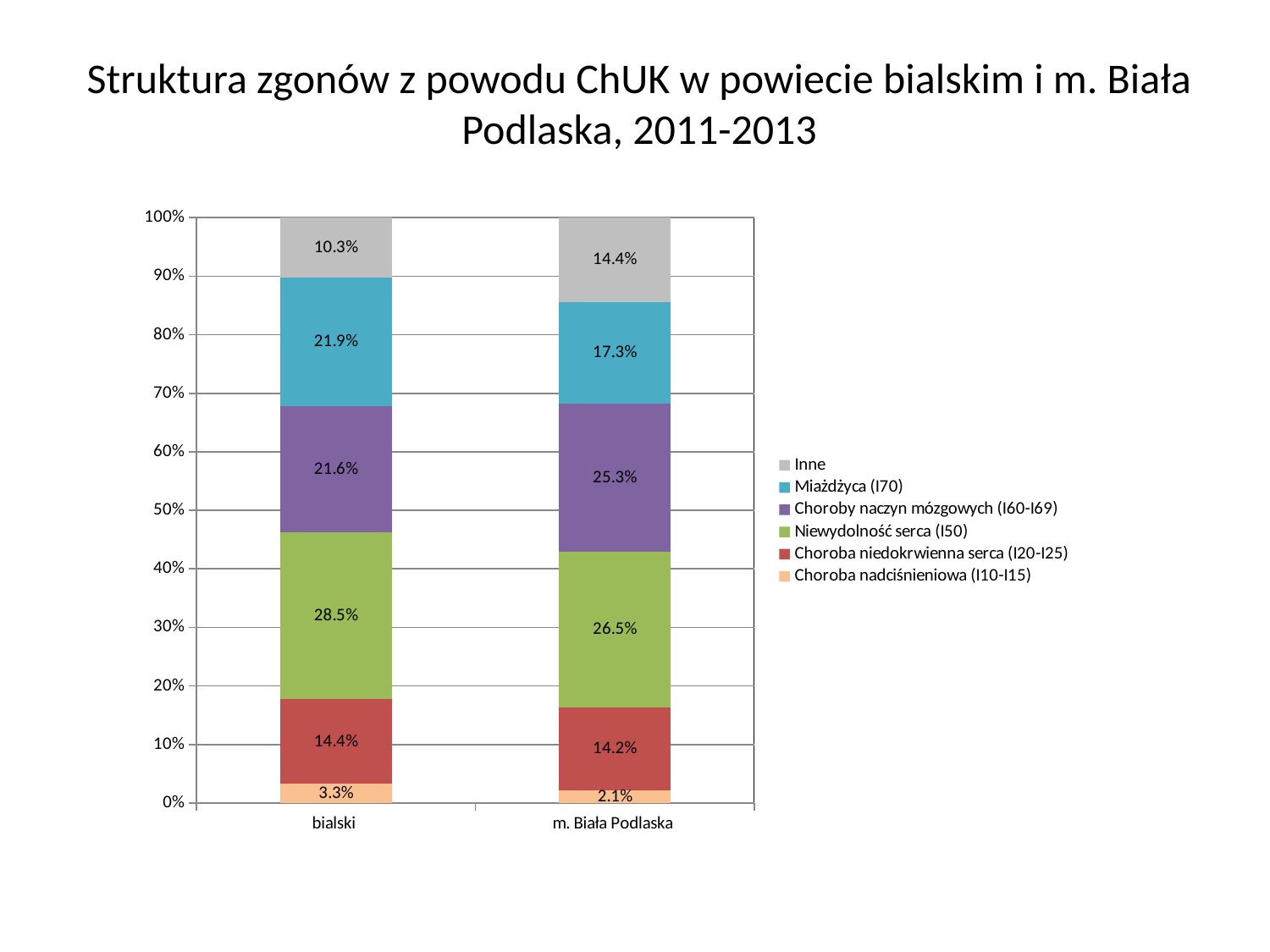
Which has a larger share of Miażdżyca (I70): bialski or m. Biała Podlaska? bialski What is the value for Choroba nadciśnieniowa (I10-I15) in bialski? 3.3% How many series does the legend list? 6 What is the value for Miażdżyca (I70) in m. Biała Podlaska? 17.3% What kind of chart is shown on the slide? Stacked bar chart How many categories are shown on the x axis? 2 What share of deaths in bialski is attributed to Niewydolność serca (I50)? 28.5% What is the value for Inne in m. Biała Podlaska? 14.4% What is the difference between the Choroby naczyn mózgowych (I60-I69) shares for m. Biała Podlaska and bialski? 3.7 percentage points Which cause has the smallest share of deaths in m. Biała Podlaska? Choroba nadciśnieniowa (I10-I15) Which cause has the largest share of deaths in bialski? Niewydolność serca (I50) What colour represents Niewydolność serca (I50) in the chart? Green